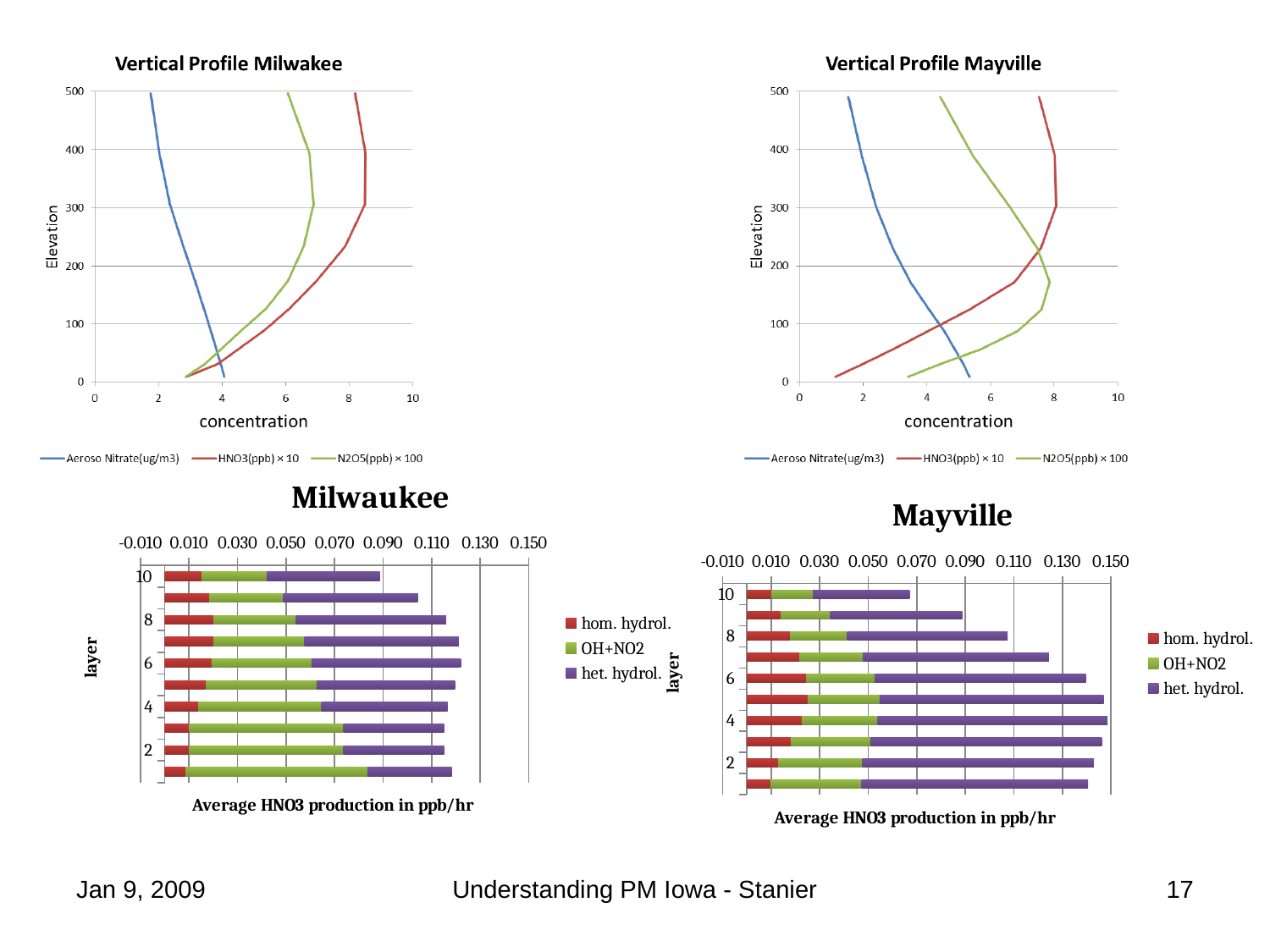
In the "Vertical Profile Mayville" chart, at elevation 500, which series has the higher concentration: HNO3(ppb) × 10 or Aeroso Nitrate(ug/m3)? HNO3(ppb) × 10 What kind of chart is the "Milwaukee" chart at the bottom left? bar chart How many series does the legend of the "Vertical Profile Milwakee" chart list? 3 In the "Vertical Profile Milwakee" chart, does the Aeroso Nitrate(ug/m3) concentration increase or decrease as elevation increases? decrease What kind of chart is the "Vertical Profile Milwakee" chart? line chart In the "Milwaukee" bar chart, which layer has the shortest total bar? 10 In the "Vertical Profile Milwakee" chart, is the HNO3(ppb) × 10 value at elevation 500 greater or less than 6? greater In the "Mayville" bar chart, is the total bar length for layer 4 greater or less than 0.130? greater How many layers (bars) are shown in the "Milwaukee" bar chart? 10 In the "Vertical Profile Mayville" chart, is the HNO3(ppb) × 10 value at elevation 0 greater or less than 2? less How many series does the legend of the "Mayville" bar chart list? 3 What are the legend entries of the "Vertical Profile Mayville" chart? Aeroso Nitrate(ug/m3), HNO3(ppb) × 10, N2O5(ppb) × 100